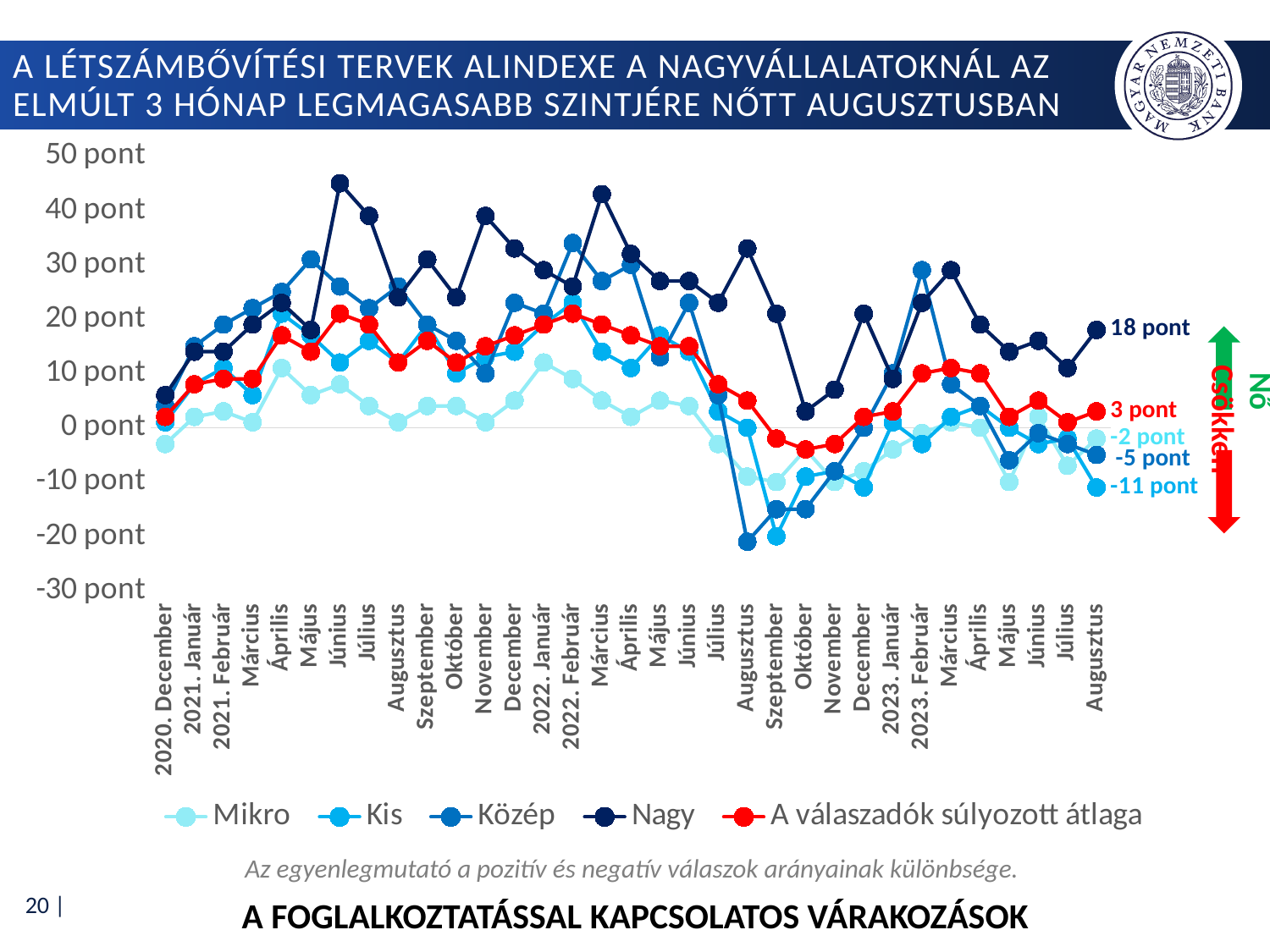
What is the value for Nagy in 2023 Augusztus? 18 pont How many months are shown on the x axis? 33 Is the value for Nagy in 2021 Június greater or less than 40 pont? greater What kind of chart is shown on the slide? line chart What is the value for Kis in 2023 Augusztus? -11 pont What is the value for Közép in 2023 Augusztus? -5 pont What is the difference between the Nagy and Kis values in 2023 Augusztus? 29 pont What is the value for Mikro in 2023 Augusztus? -2 pont How many series does the legend list? 5 Which series has the lowest value in 2023 Augusztus? Kis Which series has the highest value in 2023 Augusztus? Nagy What is the value for A válaszadók súlyozott átlaga in 2023 Augusztus? 3 pont